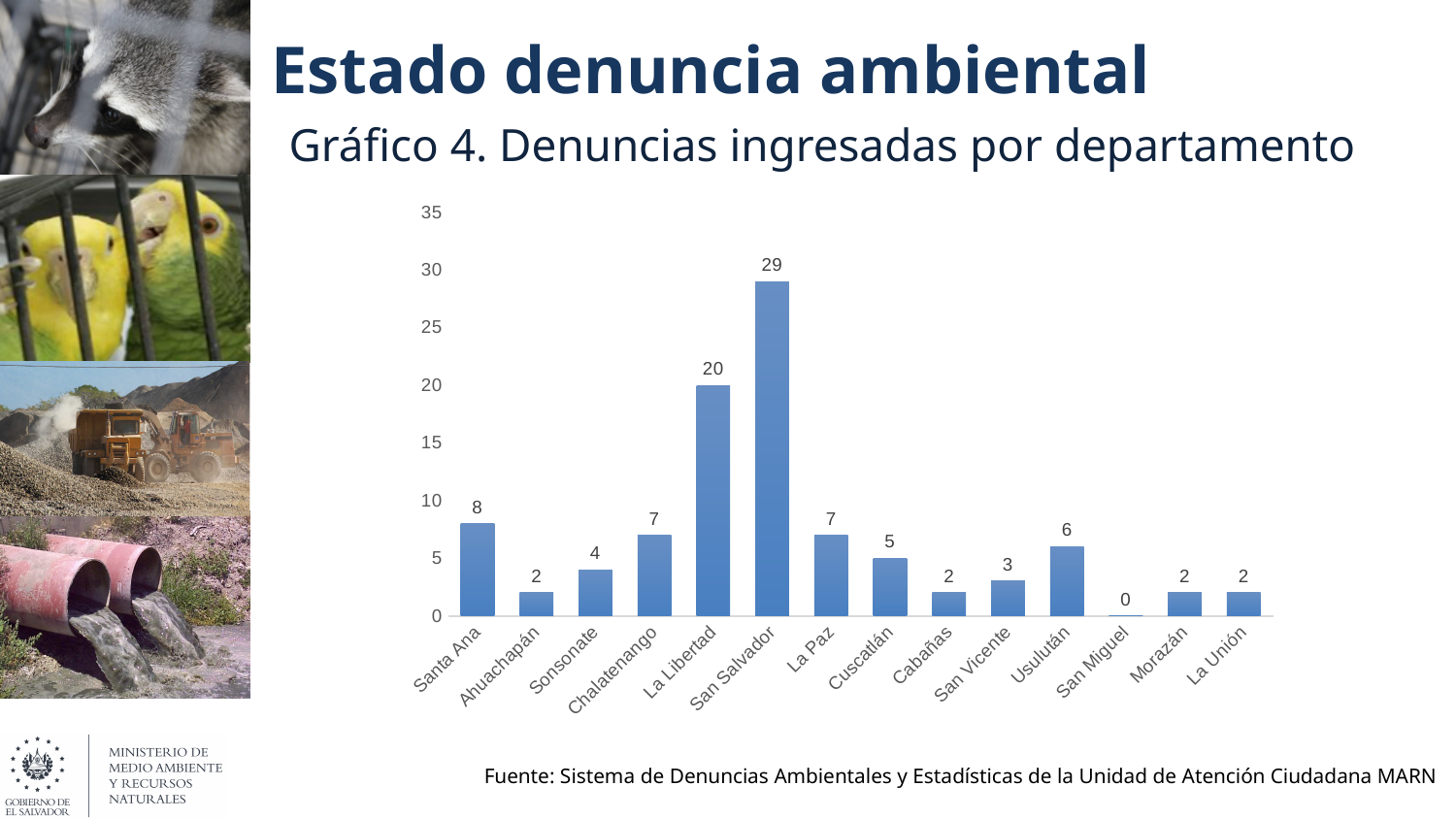
Which department has the lowest number of complaints? San Miguel Is the value for La Libertad greater or less than 15? greater What type of chart is shown on the slide? Bar chart What is the difference between the values for San Salvador and La Libertad? 9 What is the difference between the values for Santa Ana and Cuscatlán? 3 Which department has the highest number of complaints? San Salvador How many departments are shown on the x axis of the chart? 14 Which has a larger value, Chalatenango or Sonsonate? Chalatenango What is the title of the chart (Gráfico 4)? Denuncias ingresadas por departamento What is the value shown for La Libertad? 20 What is the value shown for Usulután? 6 How many complaints (denuncias) were entered for San Salvador? 29